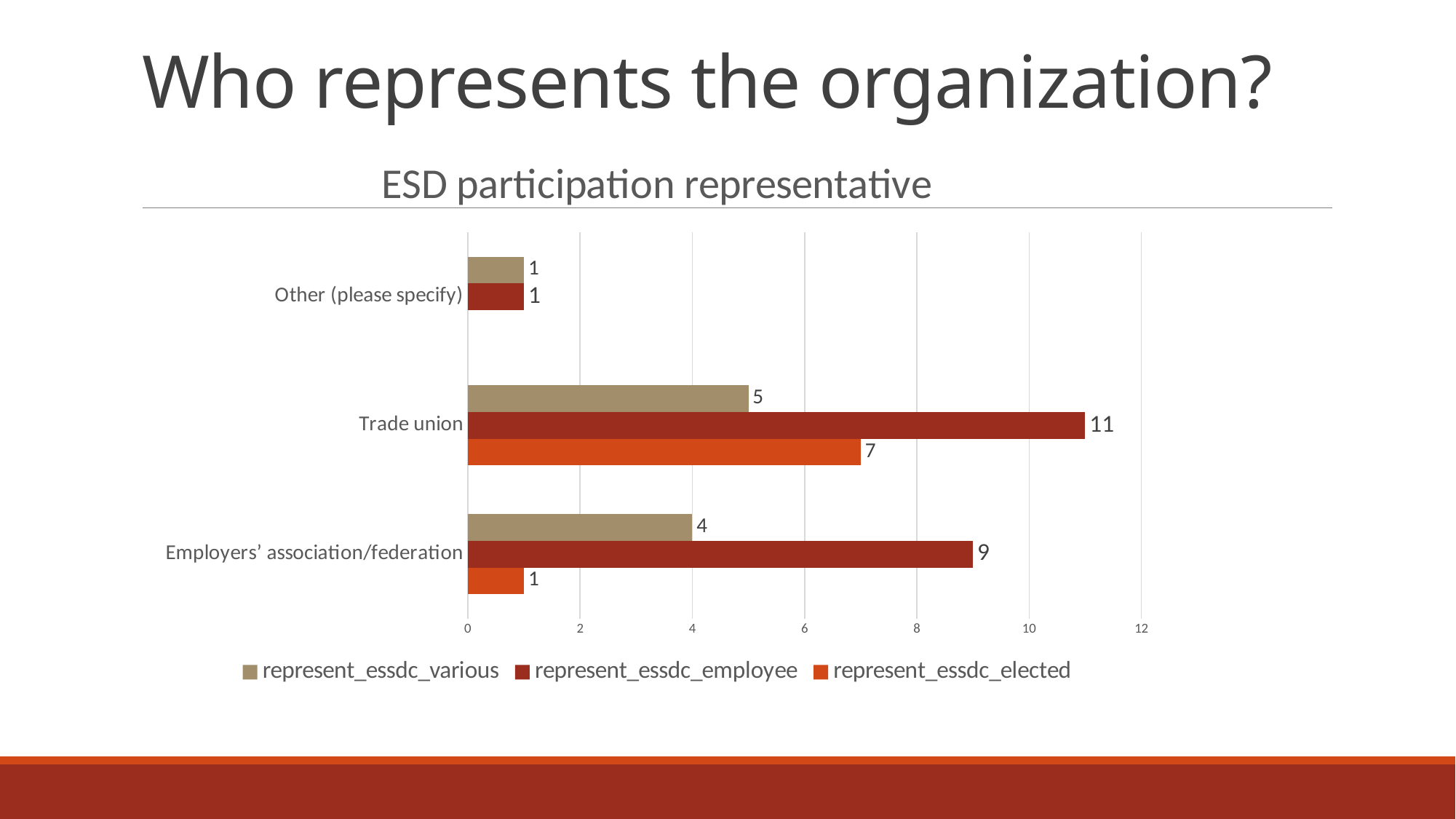
What is the value of represent_essdc_various for Trade union? 5 How many categories are shown on the chart? 3 What kind of chart is shown? Bar chart Which category has the highest value for represent_essdc_employee? Trade union How many series does the legend list? 3 What is the value of represent_essdc_elected for Employers' association/federation? 1 Which category has the lowest value for represent_essdc_various? Other (please specify) What is the title of the chart? ESD participation representative What is the difference between the represent_essdc_elected values for Trade union and Employers' association/federation? 6 What is the difference between the represent_essdc_employee values for Trade union and Employers' association/federation? 2 Which is larger for Trade union: represent_essdc_elected or represent_essdc_various? represent_essdc_elected What is the value of represent_essdc_employee for Trade union? 11